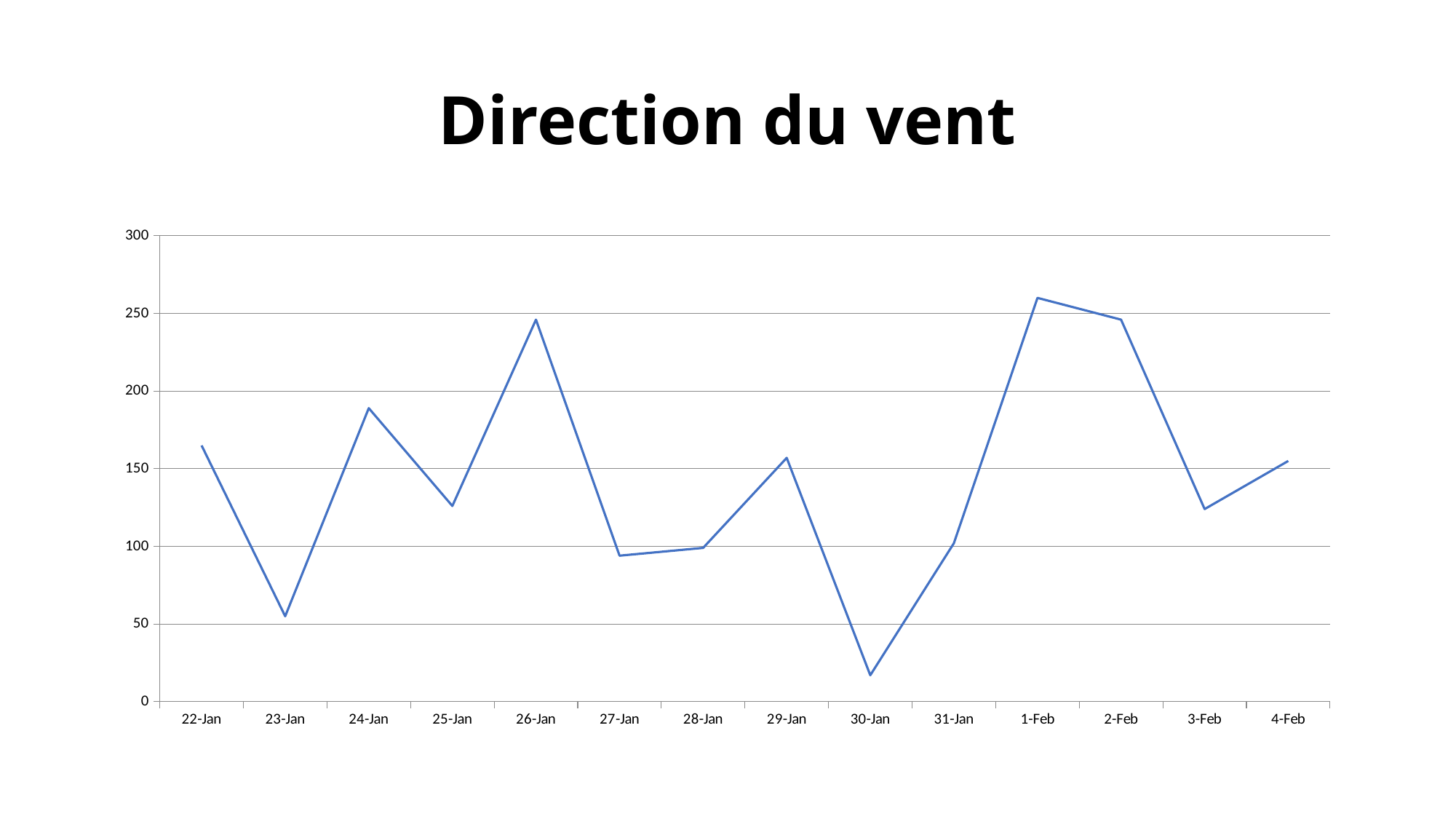
What is the title of the chart? Direction du vent On which date is the plotted value lowest? 30-Jan Is the value for 30-Jan greater or less than 50? less On which date is the plotted value highest? 1-Feb Is the value for 23-Jan greater or less than 100? less Which date has the larger value, 29-Jan or 30-Jan? 29-Jan Is the value for 1-Feb greater or less than 250? greater What kind of chart is shown on the slide? line chart Does the line rise or fall from 30-Jan to 1-Feb? rise Which date has the larger value, 24-Jan or 25-Jan? 24-Jan How many dates are plotted along the x axis? 14